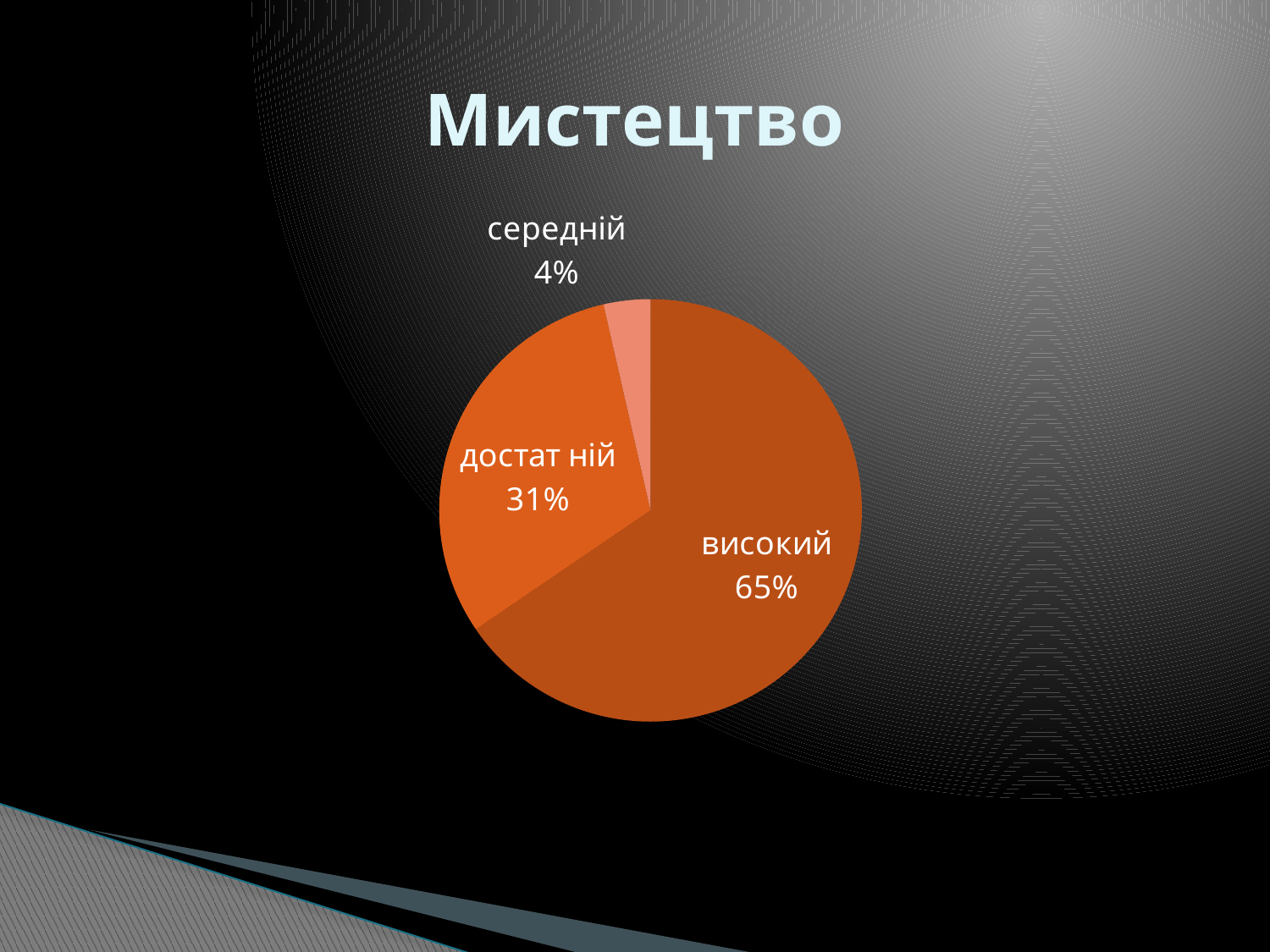
What is the difference in percentage points between the "достатній" and "середній" slices? 27 Which slice is larger, "достатній" or "середній"? достатній What is the title of the slide? Мистецтво What type of chart is shown on the slide? pie chart Which category has the largest slice of the pie? високий What share of the pie does the "середній" slice represent? 4% What is the difference in percentage points between the "високий" and "достатній" slices? 34 What share of the pie does the "достатній" slice represent? 31% What share of the pie does the "високий" slice represent? 65% Which category has the smallest slice of the pie? середній Is the "високий" slice greater or less than 50% of the pie? greater How many slices does the pie chart have? 3